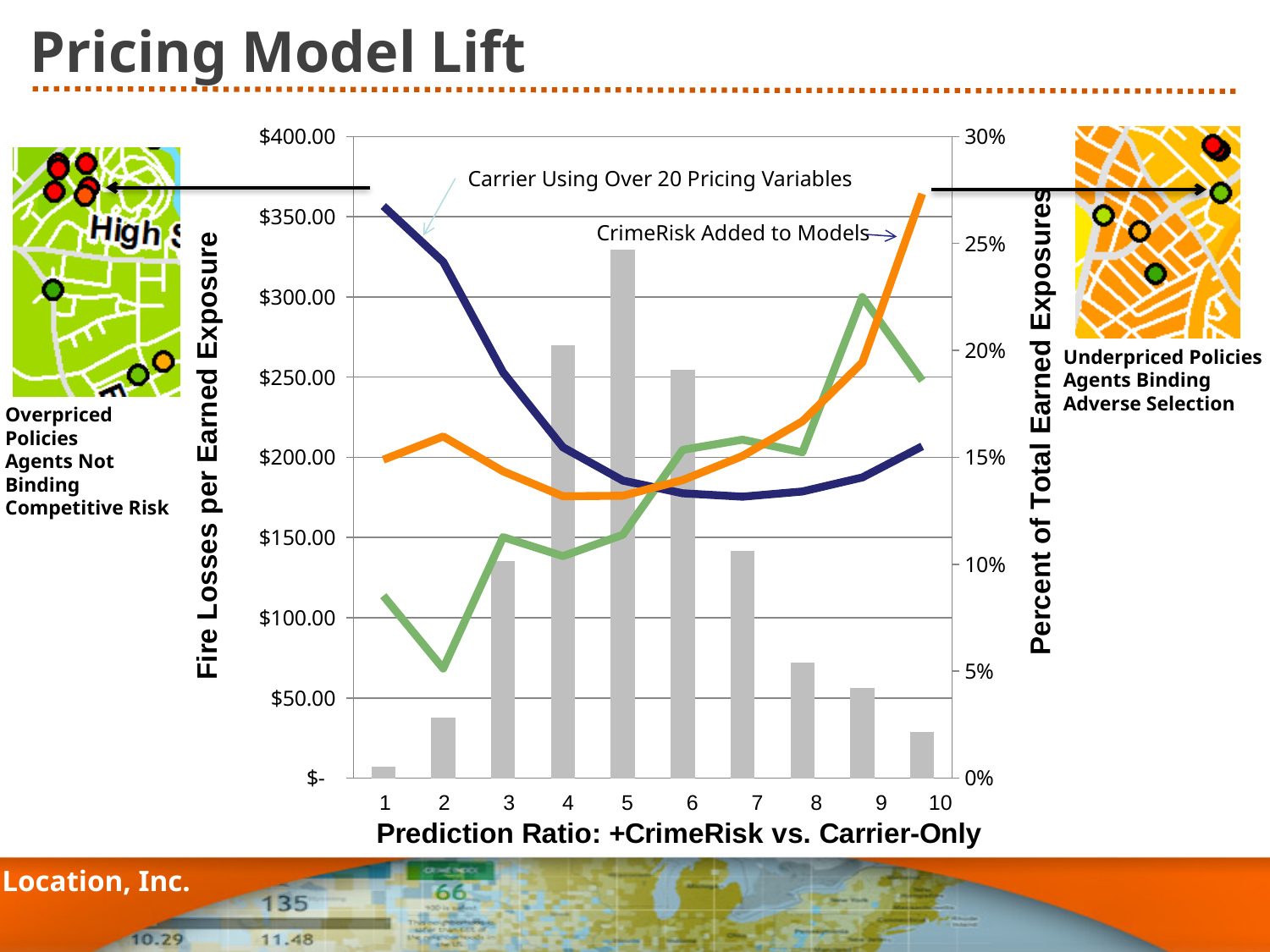
Is the 'CrimeRisk Added to Models' line at prediction ratio 10 greater or less than $350.00? greater Does the 'Carrier Using Over 20 Pricing Variables' line rise or fall from prediction ratio 1 to prediction ratio 5? fall How many prediction ratio categories are shown on the x axis? 10 At prediction ratio 10, which line is higher: 'Carrier Using Over 20 Pricing Variables' or 'CrimeRisk Added to Models'? CrimeRisk Added to Models What is the title of the left vertical axis? Fire Losses per Earned Exposure Is the 'Carrier Using Over 20 Pricing Variables' line at prediction ratio 1 greater or less than $300.00? greater At prediction ratio 1, which line is higher: 'Carrier Using Over 20 Pricing Variables' or 'CrimeRisk Added to Models'? Carrier Using Over 20 Pricing Variables Is the gray bar at prediction ratio 1 greater or less than 5%? less At which prediction ratio is the gray bar (Percent of Total Earned Exposures) highest? 5 What kind of chart is shown on the slide? A combined bar and line chart At which prediction ratio is the gray bar (Percent of Total Earned Exposures) lowest? 1